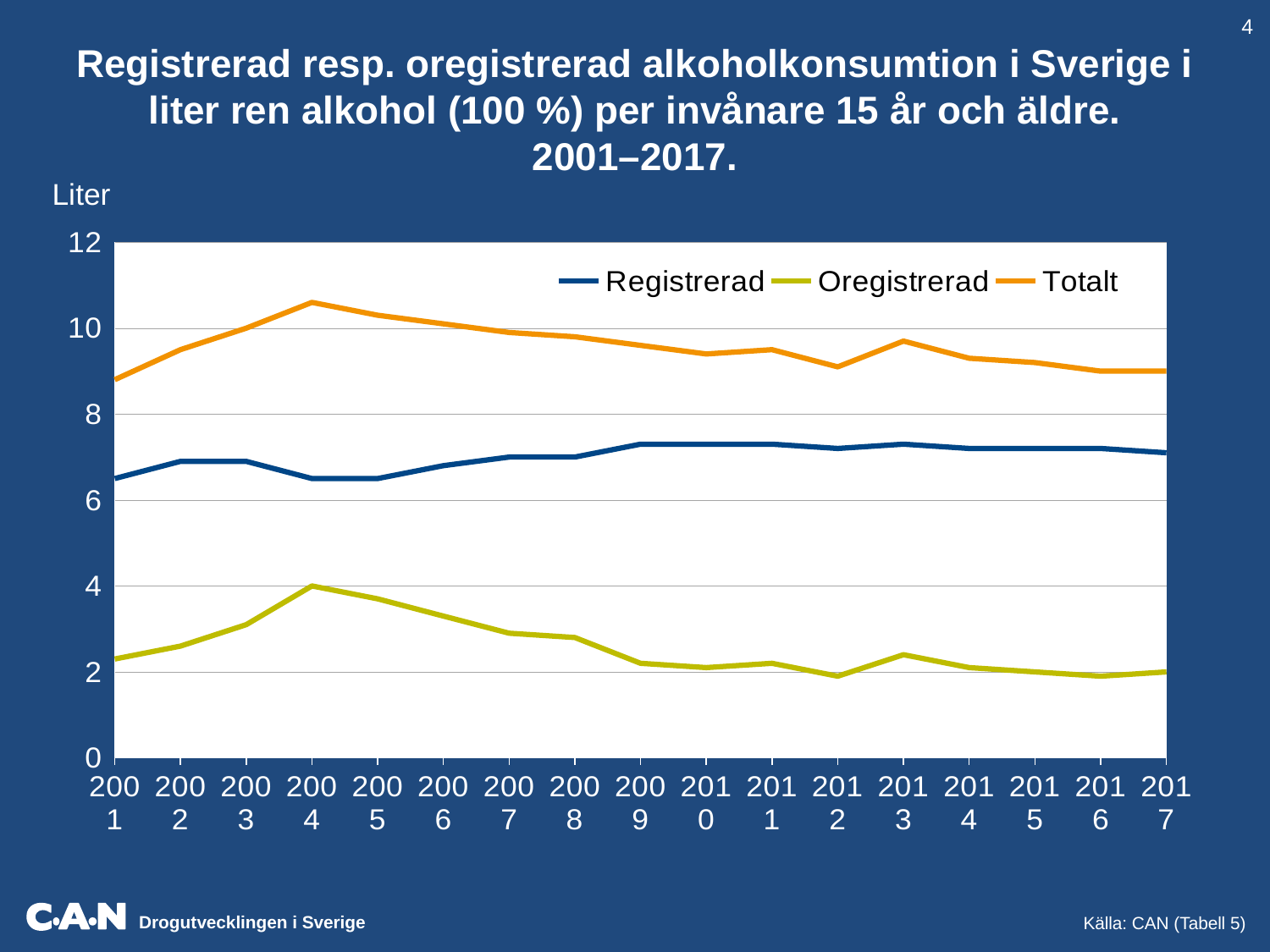
Is the value for Totalt in 2004 greater or less than 10? greater What kind of chart is shown on the slide? line chart How many series does the legend list? 3 Is the value for Registrerad in 2001 greater or less than 6? greater In which year does the Oregistrerad series reach its highest value? 2004 Does the Oregistrerad series rise or fall between 2004 and 2012? fall In which year is the Totalt series at its lowest value? 2001 Is the value for Totalt in 2017 greater or less than 10? less How many years are plotted along the x axis? 17 What label is shown on the y axis of the chart? Liter In which year does the Totalt series reach its highest value? 2004 Which series has the larger value in 2004, Registrerad or Oregistrerad? Registrerad